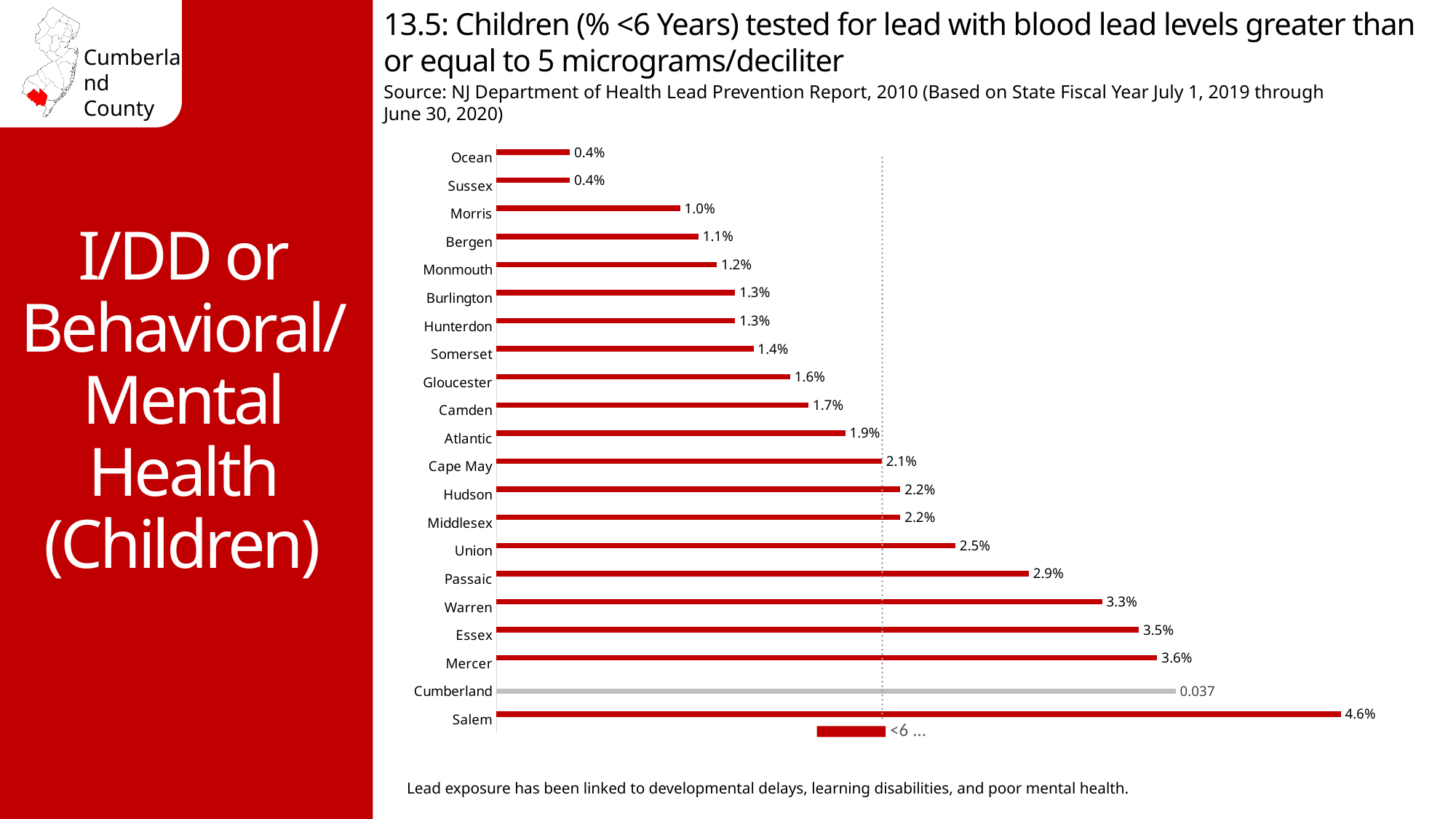
What is the value for Cape May? 2.1% Which is larger, the value for Morris or the value for Gloucester? Gloucester Which is larger, the value for Passaic or the value for Union? Passaic What is the difference between the values for Salem and Mercer? 1.0% Which county has the highest value? Salem What is the difference between the values for Essex and Warren? 0.2% What is the value for Mercer? 3.6% How many counties are listed on the chart? 21 What kind of chart is shown on the slide? bar chart What colour is the Cumberland bar? gray What is the value for Salem? 4.6% What value is printed next to the Cumberland bar? 0.037